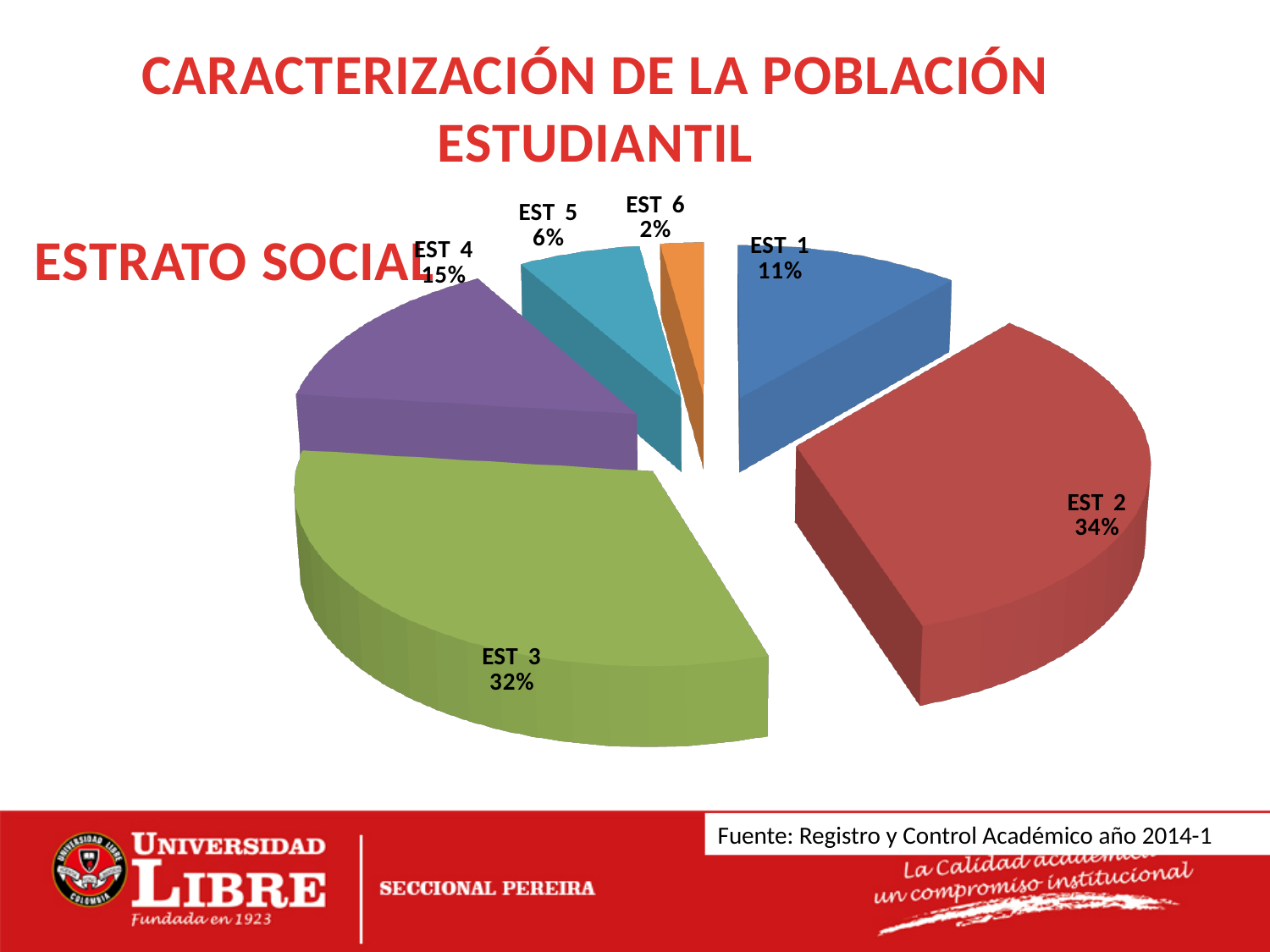
Which category has the largest slice of the pie? EST 2 What share of the pie does EST 2 represent? 34% How many categories (slices) does the pie chart have? 6 What is the title of the pie chart? ESTRATO SOCIAL Which category has the smallest slice of the pie? EST 6 What percentage is shown for EST 1? 11% What kind of chart is shown on the slide? Pie chart Which is larger, the share for EST 1 or the share for EST 4? EST 4 What is the difference in percentage points between EST 4 and EST 5? 9 What percentage is shown for EST 4? 15% What share of the pie does EST 3 represent? 32% What percentage is shown for EST 6? 2%